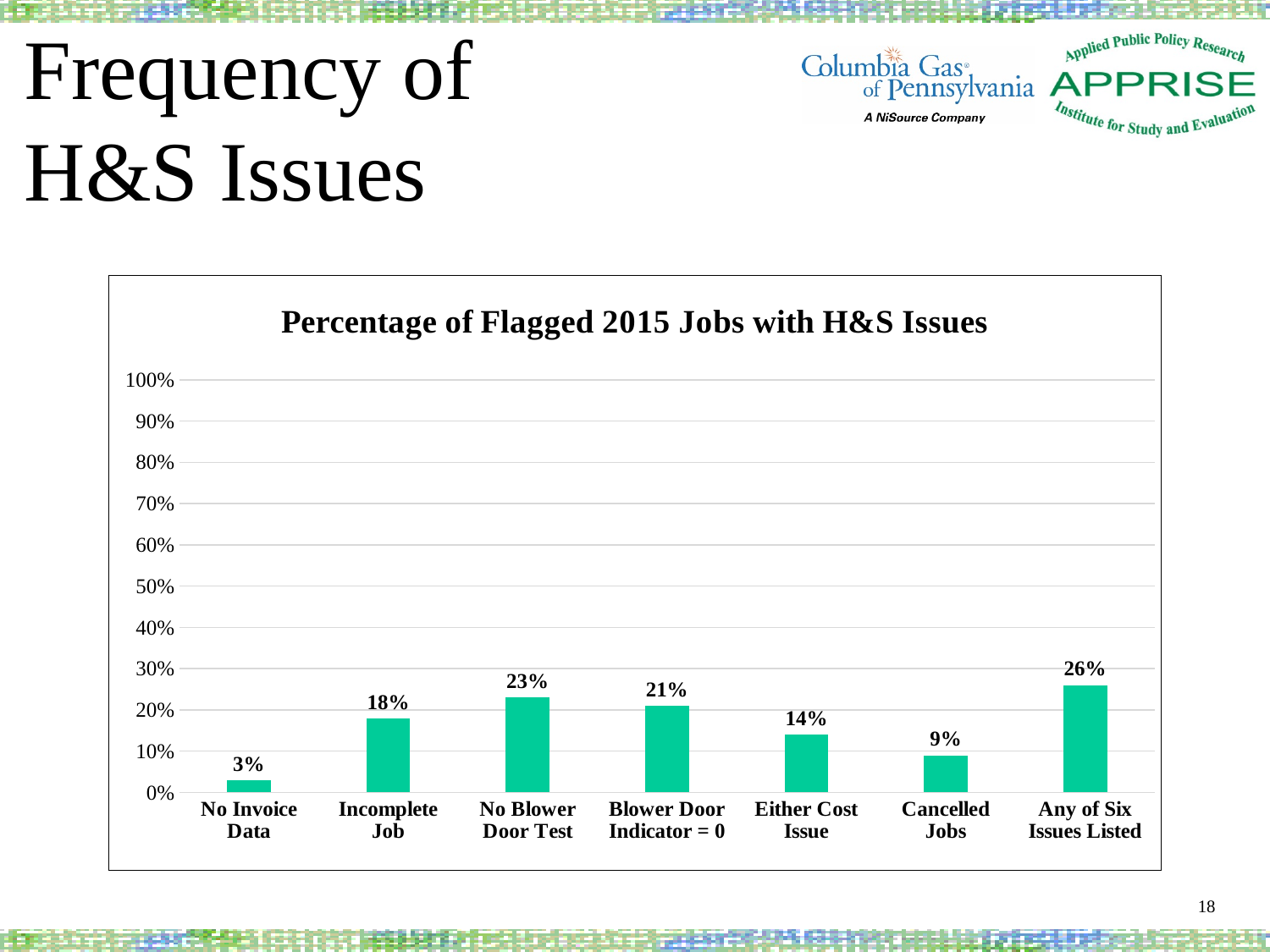
What kind of chart is shown? bar chart How many categories are shown on the x axis? 7 Which category has the highest value? Any of Six Issues Listed Is the value for Any of Six Issues Listed greater or less than 20%? greater What is the value for Cancelled Jobs? 9% What is the value for No Invoice Data? 3% Which category has the lowest value? No Invoice Data What is the value for Blower Door Indicator = 0? 21% Which is larger, the value for Incomplete Job or the value for Cancelled Jobs? Incomplete Job What is the highest value shown on the y axis? 100% What is the title of the chart? Percentage of Flagged 2015 Jobs with H&S Issues What is the difference between the values for No Blower Door Test and Either Cost Issue? 9%